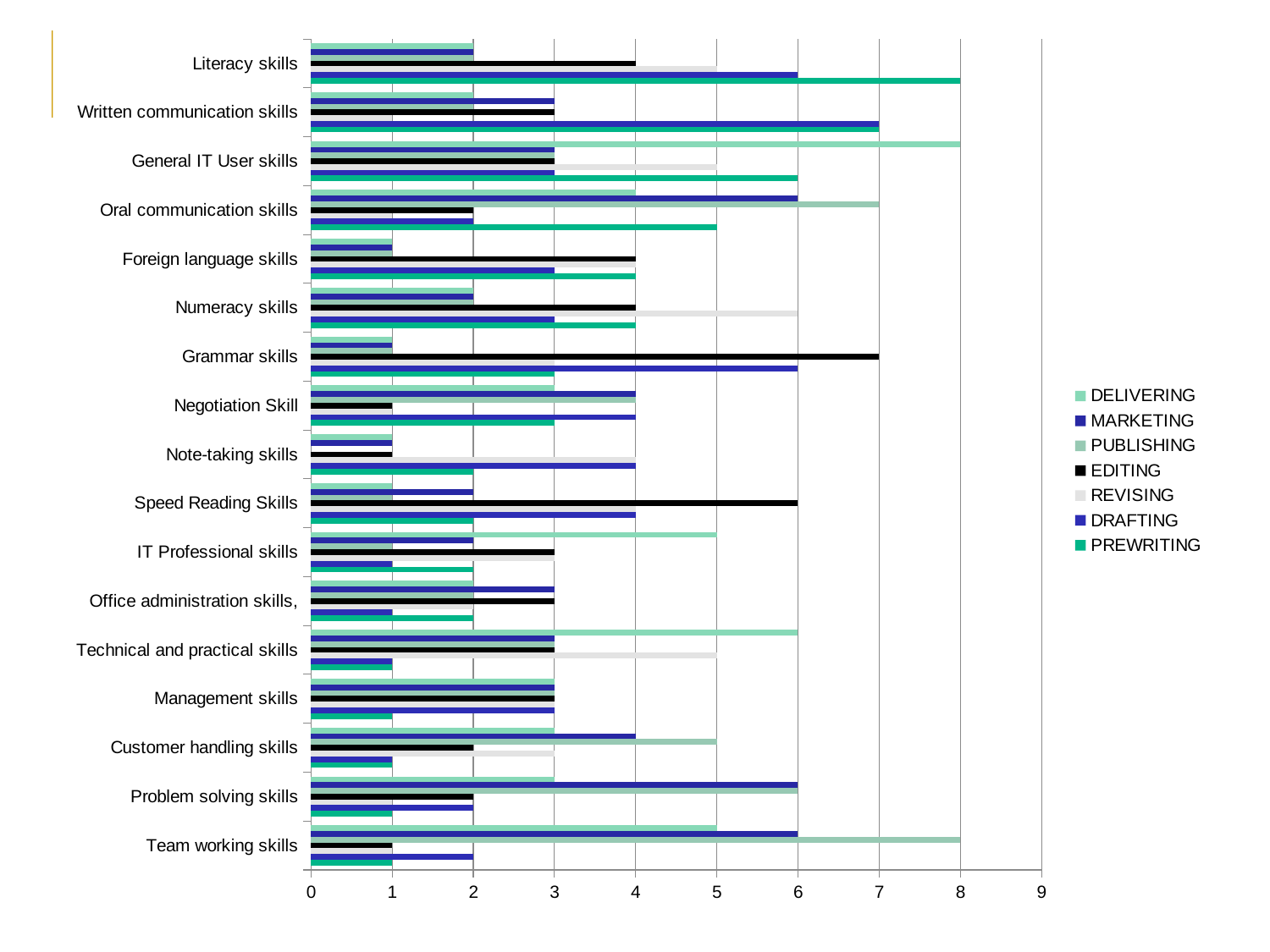
Which series has the lowest value for Oral communication skills? REVISING How many series does the legend list? 7 What kind of chart is shown on the slide? Bar chart What is the DELIVERING value for General IT User skills? 8 For Numeracy skills, which is larger: the REVISING value or the EDITING value? REVISING What is the EDITING value for Grammar skills? 7 Is the MARKETING value for Problem solving skills greater or less than 4? greater What is the PREWRITING value for Literacy skills? 8 How many skill categories are shown on the chart? 17 What is the PUBLISHING value for Team working skills? 8 Which series has the highest value for Speed Reading Skills? EDITING What is the difference between the DRAFTING and DELIVERING values for Literacy skills? 4